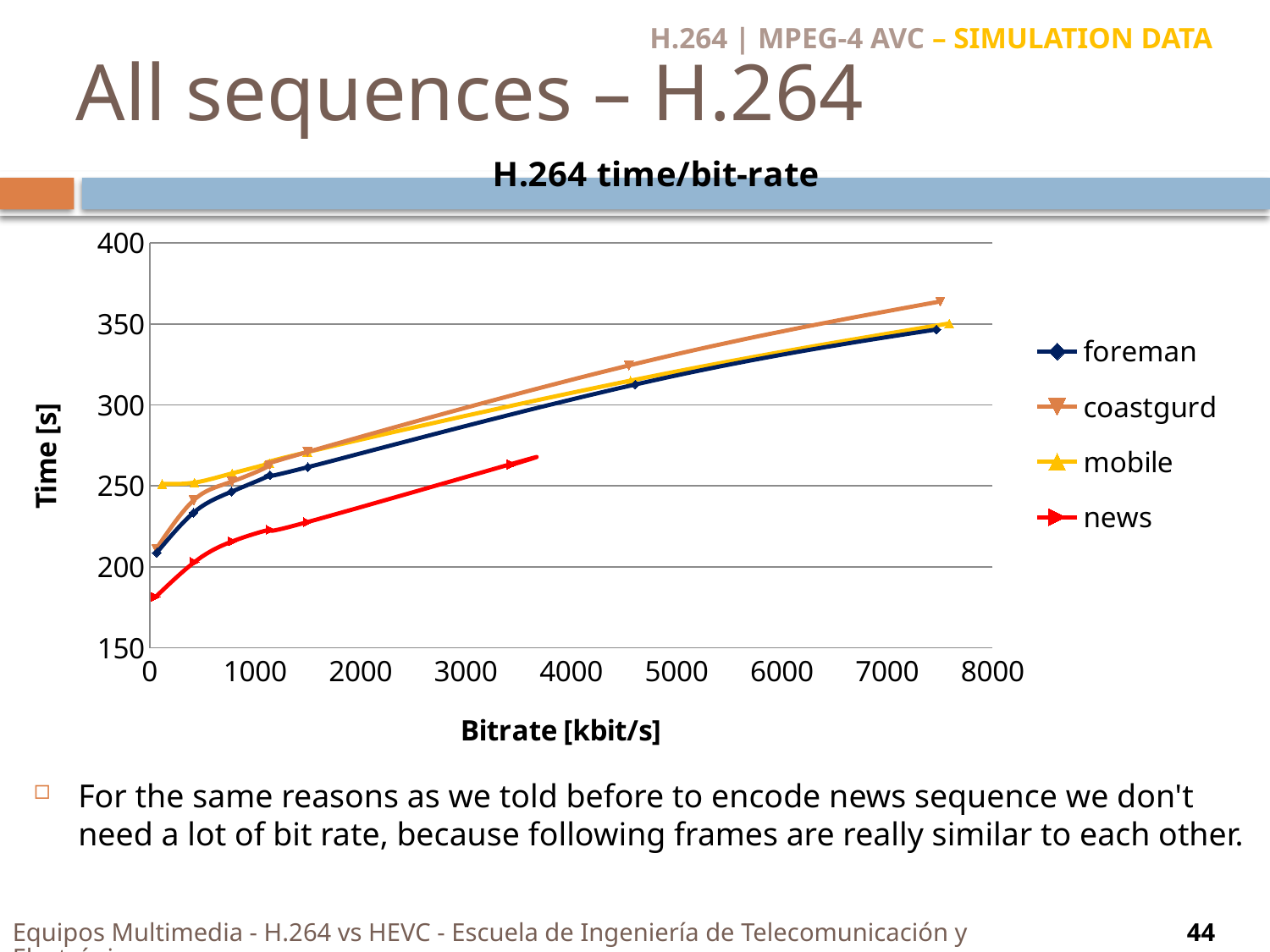
Does the time for the news series rise or fall as bitrate increases? rise Is the highest time value for the news series greater or less than 300? less How many series does the legend list? 4 What kind of chart is shown on the slide? line chart Which series has the lowest time values across the chart? news Is the lowest time value for the news series greater or less than 200? less Which series reaches the highest time value on the chart? coastgurd Does the time for the foreman series rise or fall as bitrate increases? rise Is the highest time value for the coastgurd series greater or less than 350? greater At a bitrate of about 4600 kbit/s, which series has the larger time, coastgurd or foreman? coastgurd What is the label of the vertical axis? Time [s] What is the title of the chart? H.264 time/bit-rate